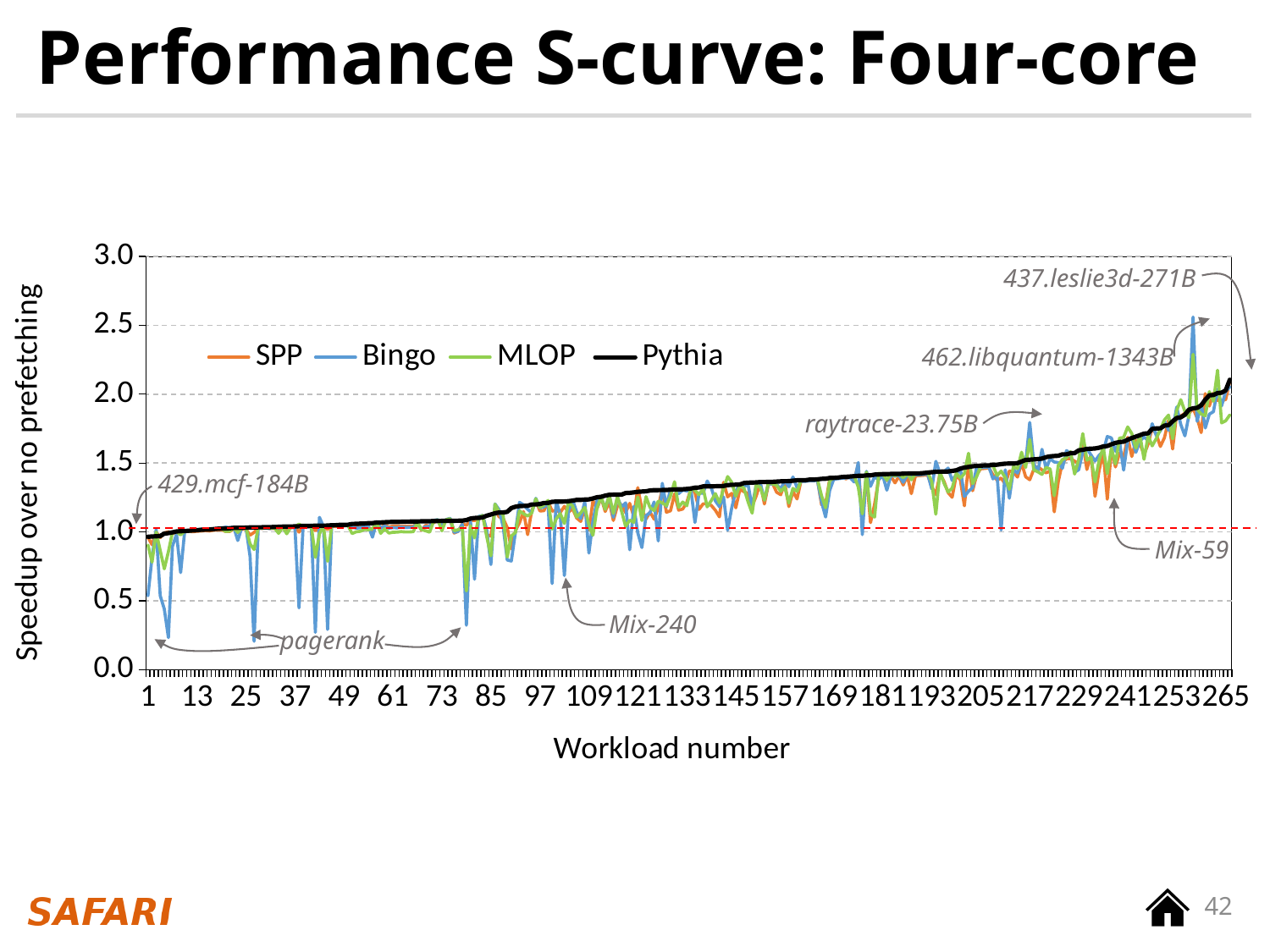
Is the Pythia value at workload 1 greater or less than 1.5? less Is the Pythia value at workload 265 greater or less than 1.5? greater What is the title of the slide containing the chart? Performance S-curve: Four-core How many series does the legend list? 4 Does the Pythia line rise or fall as the workload number increases? Rises What kind of chart is shown on the slide? Line chart What is the highest tick value shown on the y axis? 3.0 Which series are listed in the chart legend? SPP, Bingo, MLOP, Pythia Is the peak Bingo value near the workload labelled 462.libquantum-1343B greater or less than 2.0? greater